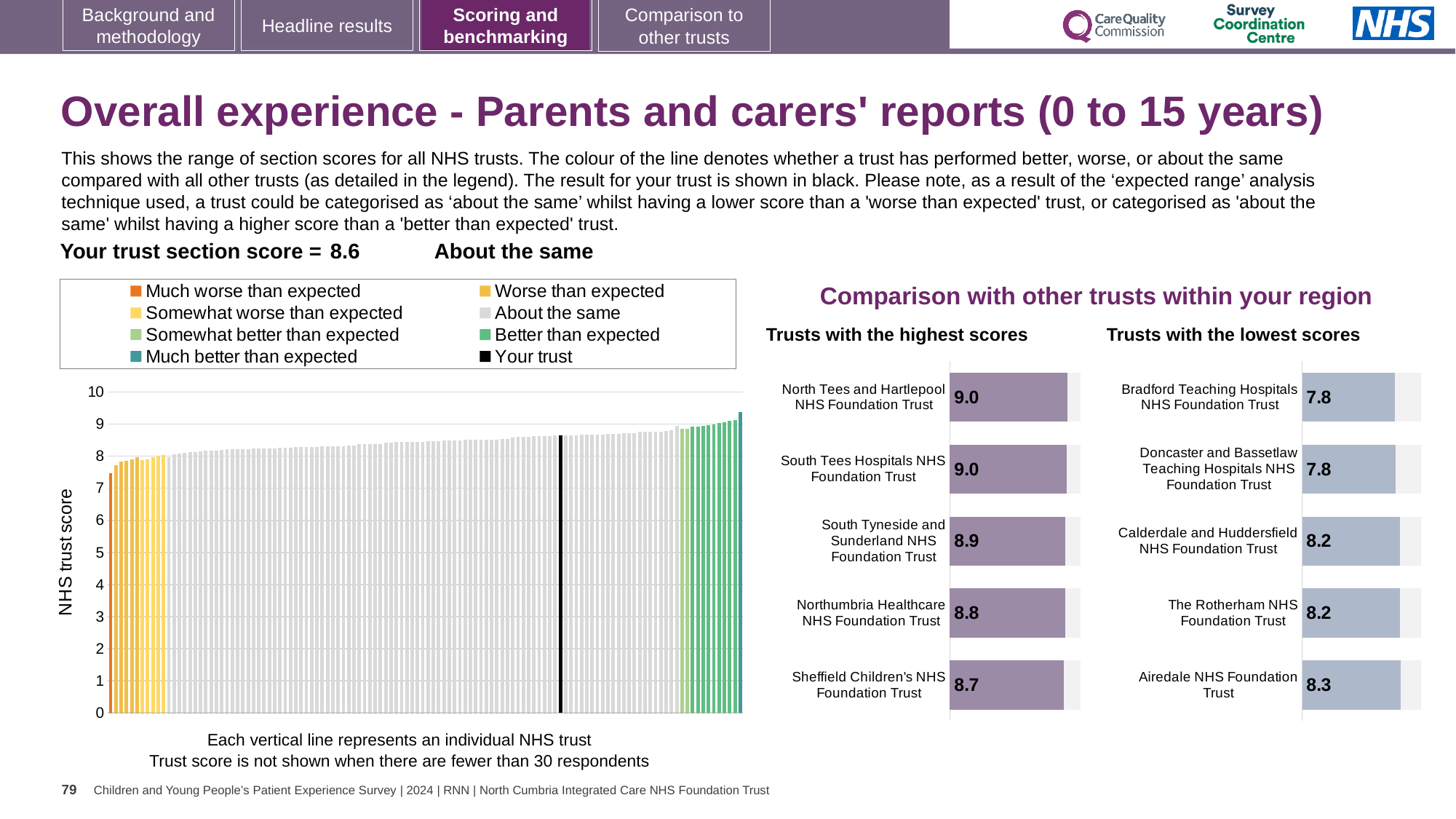
In the large chart on the left, is the value of the black bar (your trust) greater or less than 8? greater What is the difference between the score for North Tees and Hartlepool NHS Foundation Trust in the 'Trusts with the highest scores' chart and the score for Bradford Teaching Hospitals NHS Foundation Trust in the 'Trusts with the lowest scores' chart? 1.2 How many trusts are shown in the 'Trusts with the highest scores' chart? 5 In the 'Trusts with the highest scores' chart, what is the score for Northumbria Healthcare NHS Foundation Trust? 8.8 What kind of chart is the large chart on the left showing NHS trust scores? bar chart In the 'Trusts with the lowest scores' chart, which trust has the highest score? Airedale NHS Foundation Trust In the large chart on the left, is the value of the leftmost (lowest) bar greater or less than 8? less In the 'Trusts with the lowest scores' chart, what is the score for Calderdale and Huddersfield NHS Foundation Trust? 8.2 In the large chart on the left, what is the label on the vertical axis? NHS trust score How many entries does the legend above the large chart on the left list? 8 In the 'Trusts with the highest scores' chart, which trust has the lowest score? Sheffield Children's NHS Foundation Trust Which has the larger score: Sheffield Children's NHS Foundation Trust in the 'Trusts with the highest scores' chart or Airedale NHS Foundation Trust in the 'Trusts with the lowest scores' chart? Sheffield Children's NHS Foundation Trust